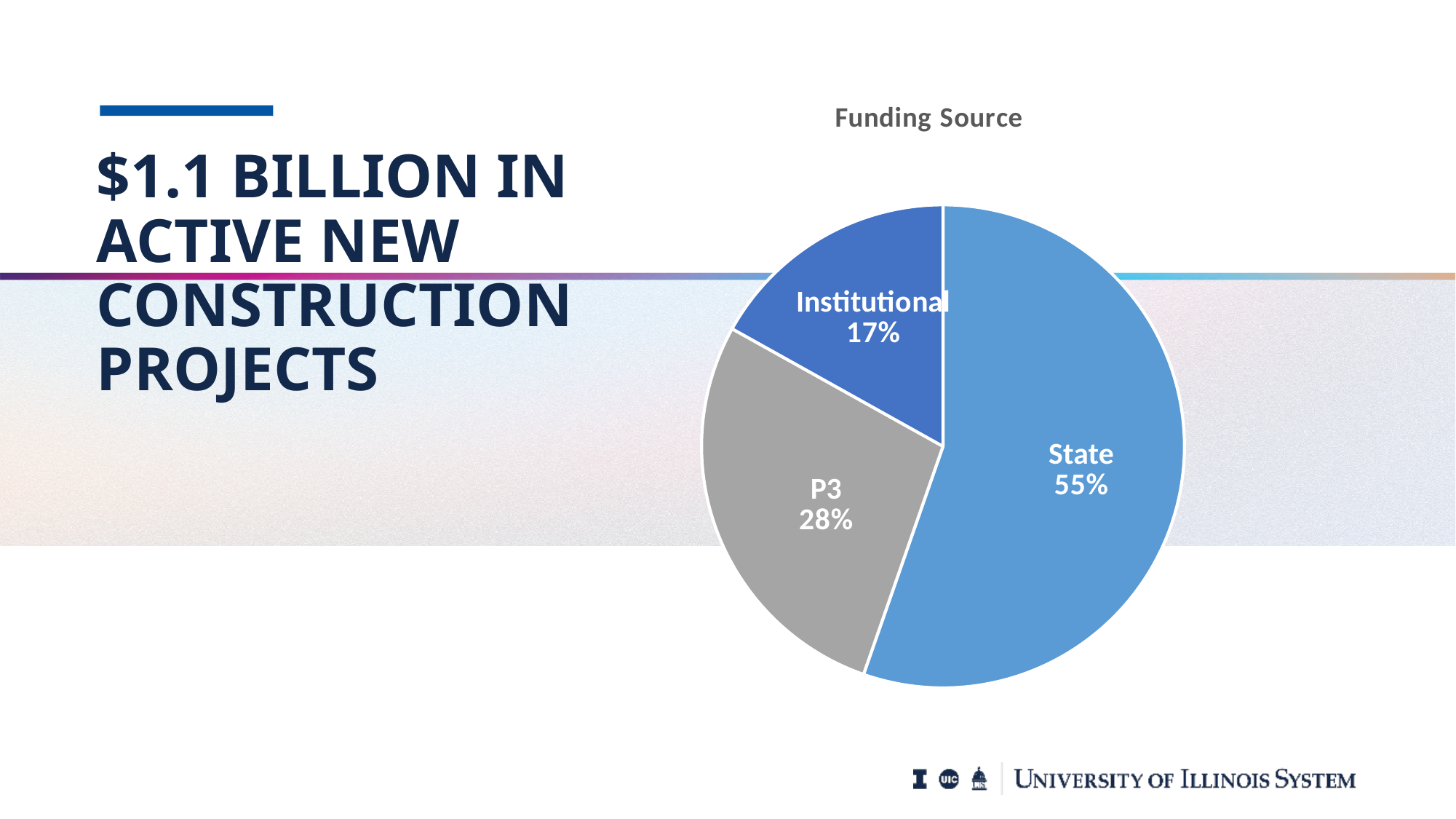
Which funding source has the largest share? State What share of funding comes from P3? 28% Which is larger, the P3 share or the Institutional share? P3 How many slices does the pie chart have? 3 What is the difference in percentage points between the P3 and Institutional shares? 11 What share of funding is Institutional? 17% Which funding source has the smallest share? Institutional What is the title of the chart? Funding Source What colour is the P3 slice? grey What share of funding comes from the State? 55% What kind of chart is shown on the slide? pie chart What is the difference in percentage points between the State and P3 shares? 27